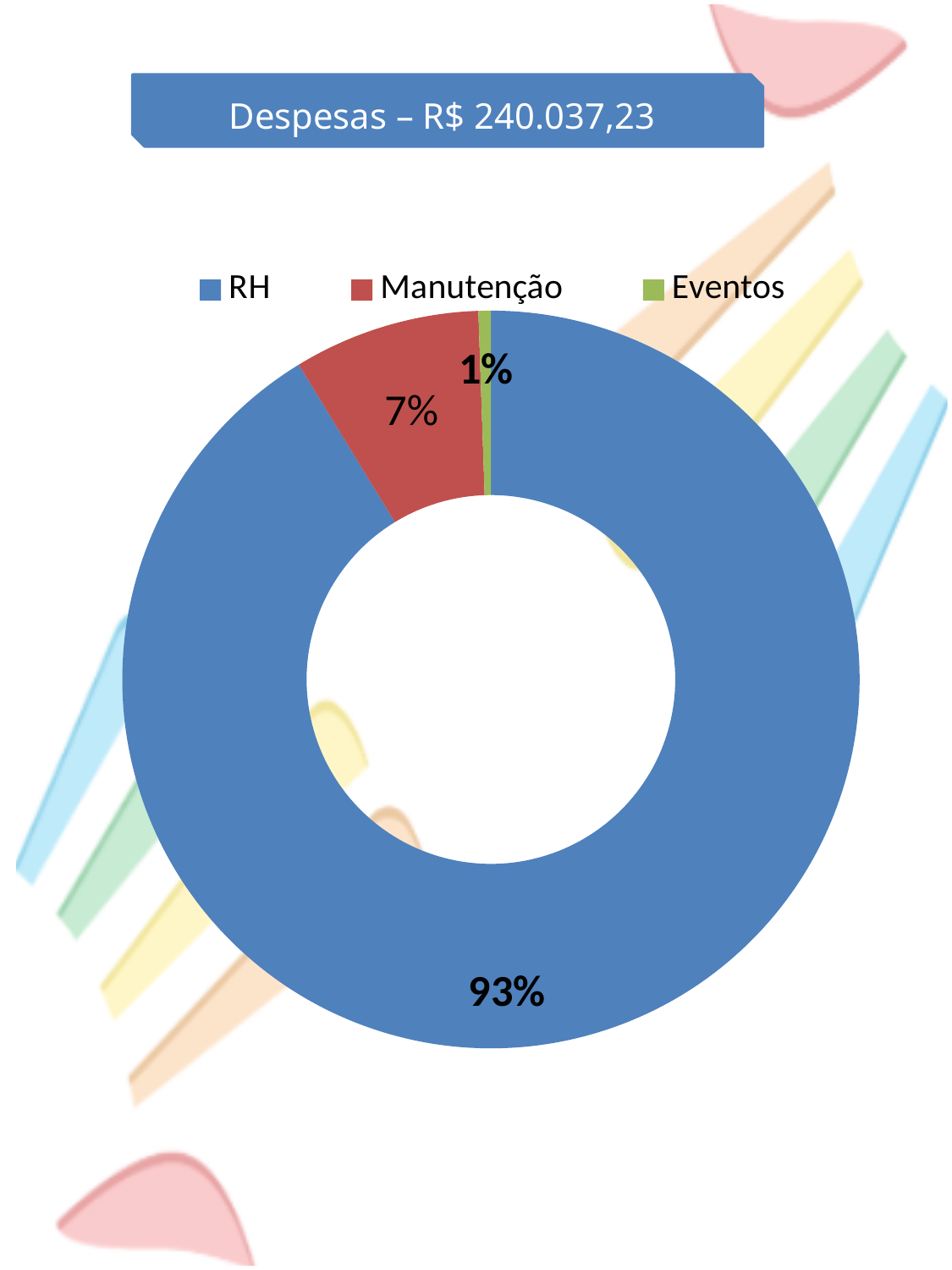
What is the title shown above the chart? Despesas – R$ 240.037,23 What colour represents Manutenção in the chart? Red What share of the chart does Eventos represent? 1% Which category has the smallest share? Eventos What is the difference in percentage points between Manutenção and Eventos? 6 What kind of chart is shown on the slide? Doughnut (pie) chart What is the difference in percentage points between RH and Manutenção? 86 Which category has the largest share? RH What share of the chart does RH represent? 93% Which is larger, the share for Manutenção or the share for Eventos? Manutenção How many categories does the chart show? 3 What share of the chart does Manutenção represent? 7%